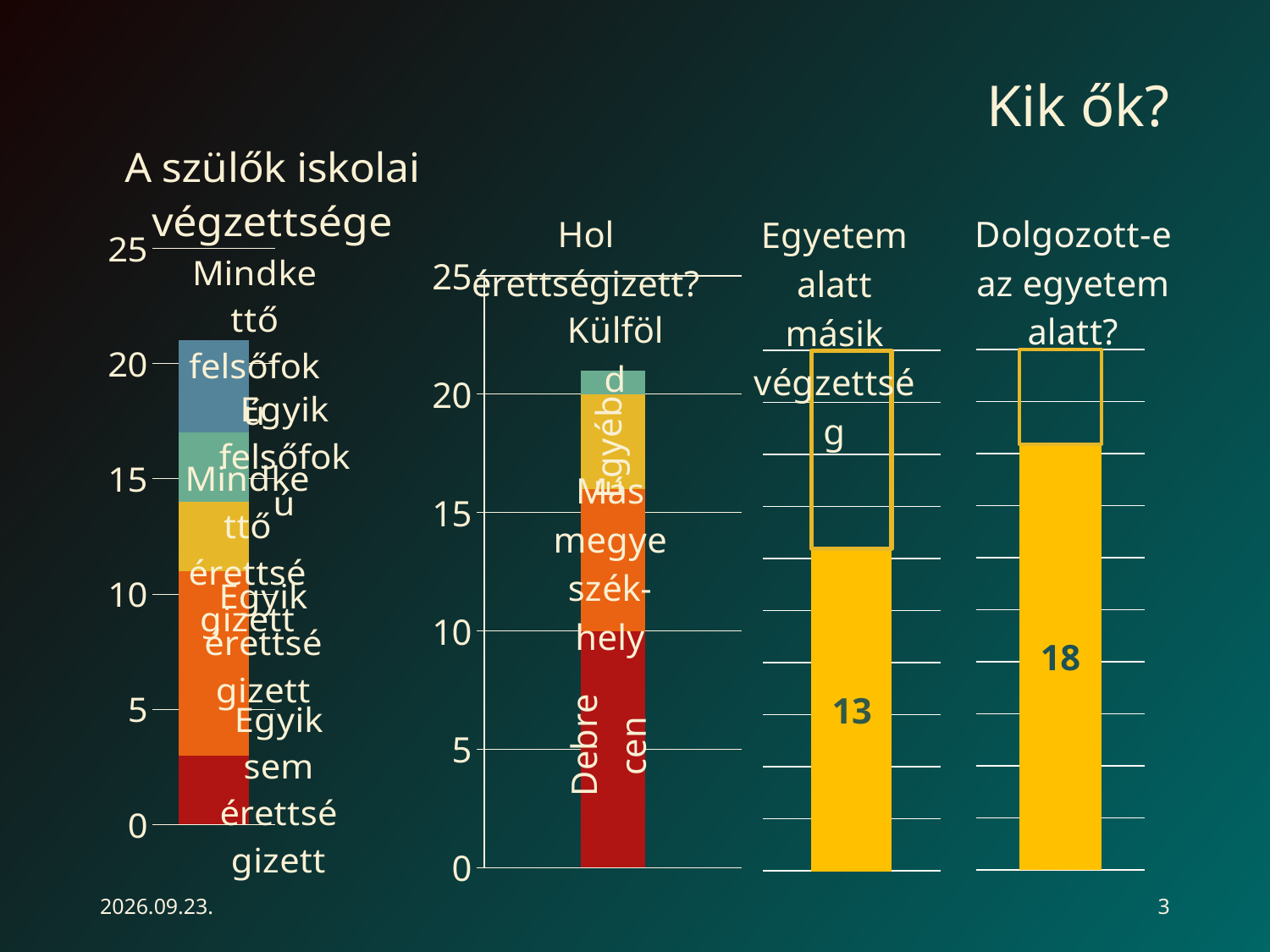
What kind of chart is "A szülők iskolai végzettsége"? Stacked bar chart In the chart "A szülők iskolai végzettsége", is the total height of the stacked bar greater or less than 15? greater In the chart "Hol érettségizett?", is the Debrecen segment's top greater or less than 15? less How many segments make up the stacked bar in the chart "A szülők iskolai végzettsége"? 5 How many segments make up the stacked bar in the chart "Hol érettségizett?"? 4 What is the difference between the value in the "Dolgozott-e az egyetem alatt?" chart (18) and the value in the "Egyetem alatt másik végzettség" chart (13)? 5 In the chart titled "Dolgozott-e az egyetem alatt?", what value is printed on the bar? 18 What colour is the filled bar in the chart "Dolgozott-e az egyetem alatt?"? Yellow In the chart "Hol érettségizett?", is the total height of the stacked bar greater or less than 15? greater What is the maximum value shown on the vertical axis of the chart "Hol érettségizett?"? 25 Which is larger: the value in the "Dolgozott-e az egyetem alatt?" chart or the value in the "Egyetem alatt másik végzettség" chart? Dolgozott-e az egyetem alatt? In the chart titled "Egyetem alatt másik végzettség", what value is printed on the bar? 13